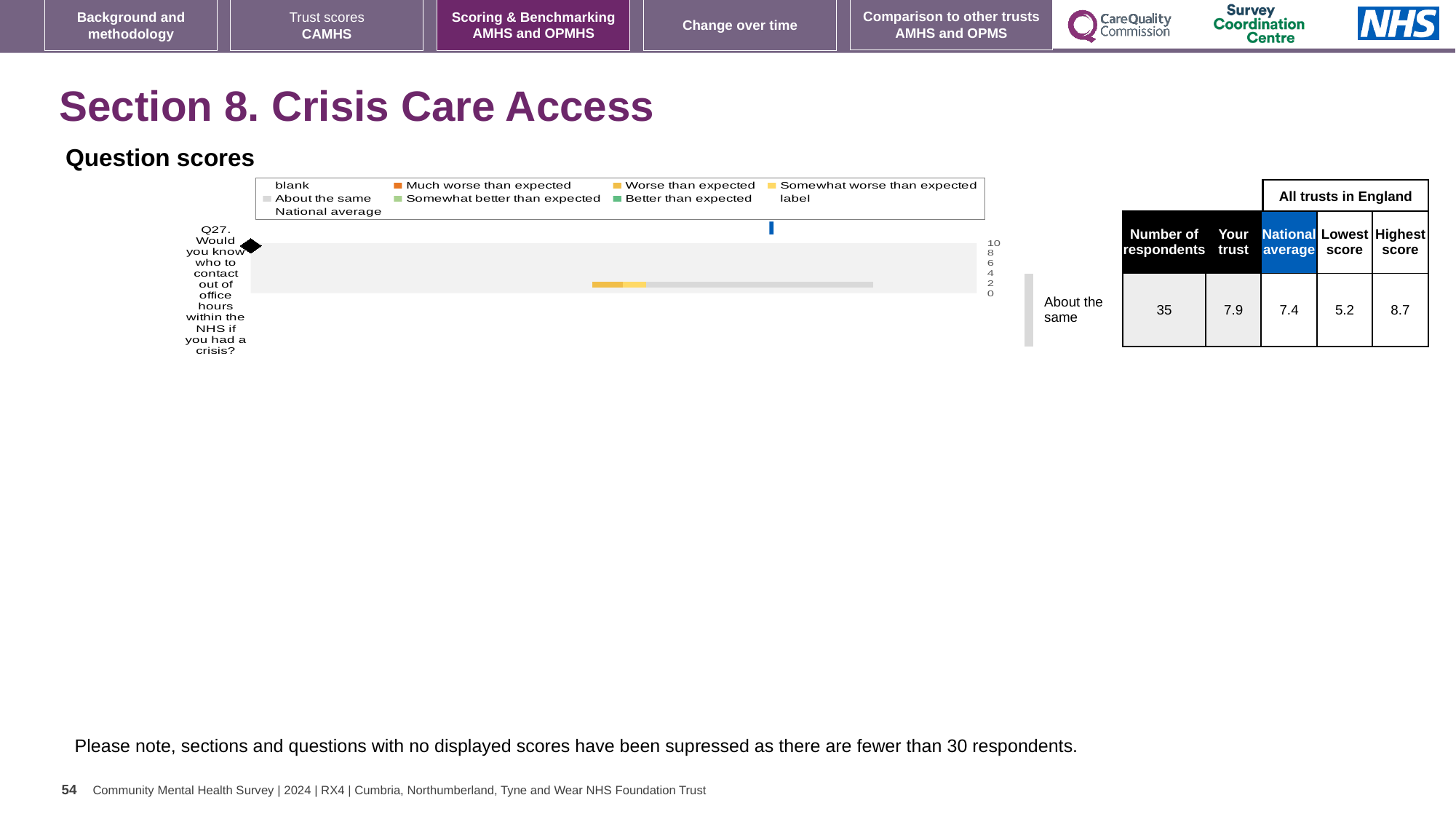
What kind of chart is used to show the question scores? bar chart What is the number of respondents for Q27 shown in the table beside the chart? 35 How many entries does the legend of the question scores chart list? 9 What is the 'Your trust' score for Q27 in the table beside the chart? 7.9 What is the highest score among all trusts in England for Q27? 8.7 Which question is plotted in the question scores chart? Q27. Would you know who to contact out of office hours within the NHS if you had a crisis? What benchmark category label is shown next to the bar for Q27? About the same What is the difference between the highest score and the lowest score for Q27 among all trusts in England? 3.5 Which is larger for Q27, the 'Your trust' score or the national average? Your trust What is the national average score for Q27 in the table beside the chart? 7.4 How many questions are plotted in the question scores chart? 1 What is the lowest score among all trusts in England for Q27? 5.2